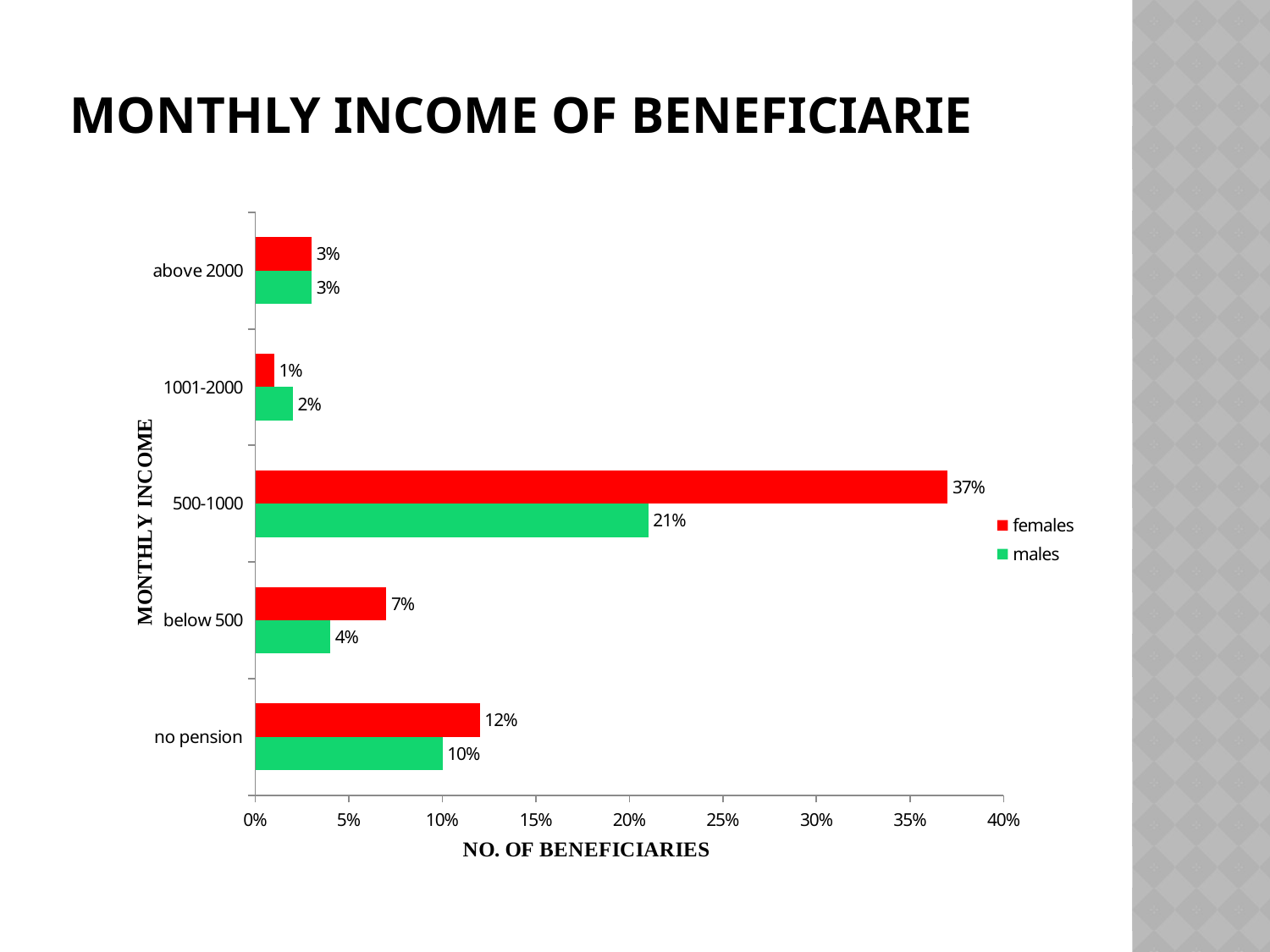
Is the value for females in the 500-1000 category greater or less than 35%? greater What kind of chart is shown on the slide? bar chart What is the value for females in the 500-1000 income category? 37% What is the value for males in the no pension category? 10% What is the difference between the female and male values in the 500-1000 category? 16% What is the label of the horizontal axis? NO. OF BENEFICIARIES What is the value for males in the 1001-2000 income category? 2% How many income categories are shown on the chart? 5 Which is larger in the below 500 category, the value for females or for males? females Which income category has the lowest value for females? 1001-2000 How many series does the legend list? 2 Which income category has the highest value for females? 500-1000